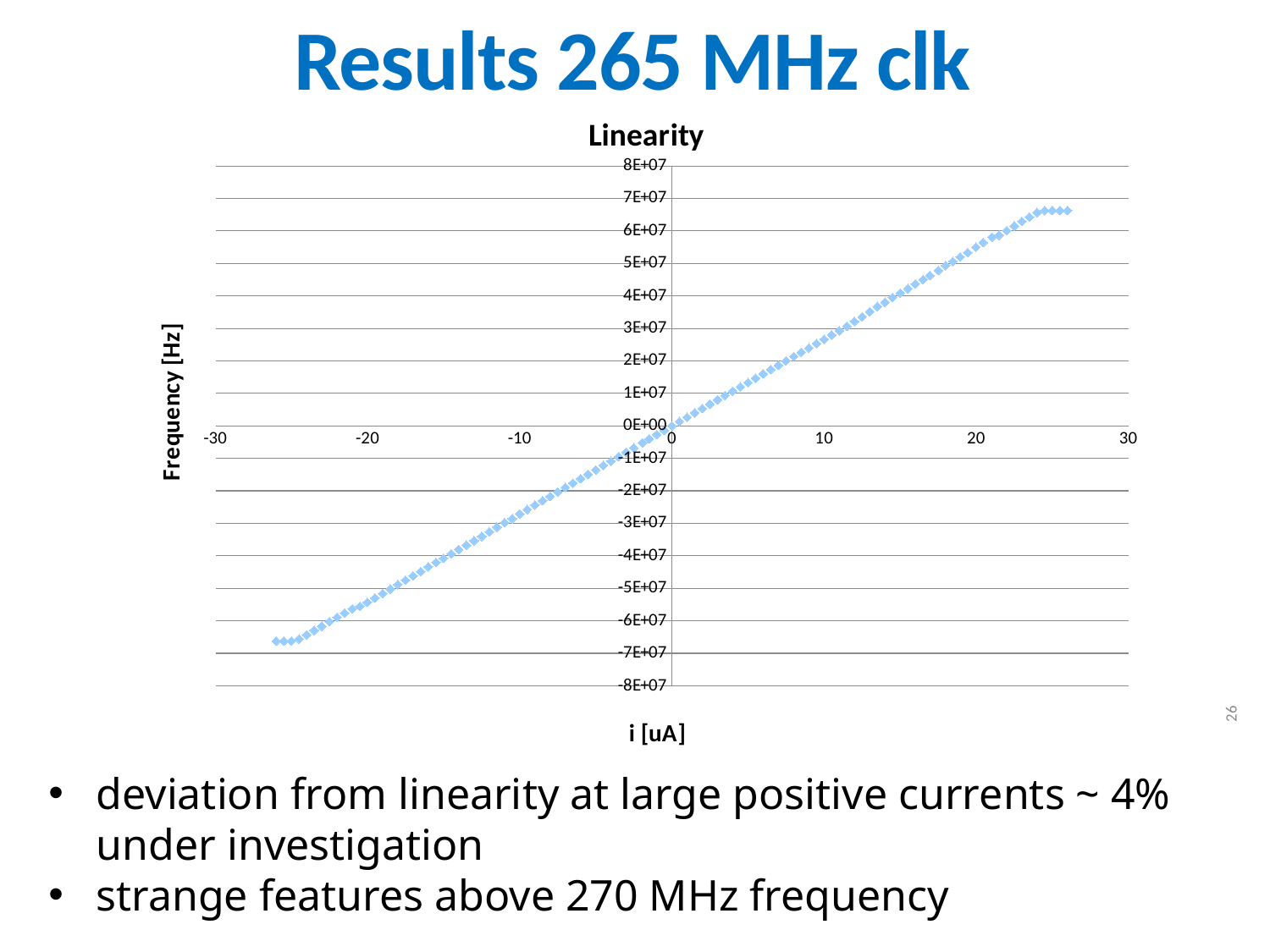
Is the frequency value at i = -10 uA greater or less than -2E+07? less What is the label of the y axis of the chart? Frequency [Hz] Is the highest plotted frequency value greater or less than 7E+07? less Which has the larger frequency value: the point at i = -10 uA or the point at i = 5 uA? i = 5 uA Is the frequency value at i = 10 uA greater or less than 3E+07? less Which has the larger frequency value: the point at i = 20 uA or the point at i = 10 uA? i = 20 uA What is the title of the chart? Linearity What kind of chart is shown on the slide? scatter chart Do the plotted frequency values rise or fall as the current i increases along the x axis? rise